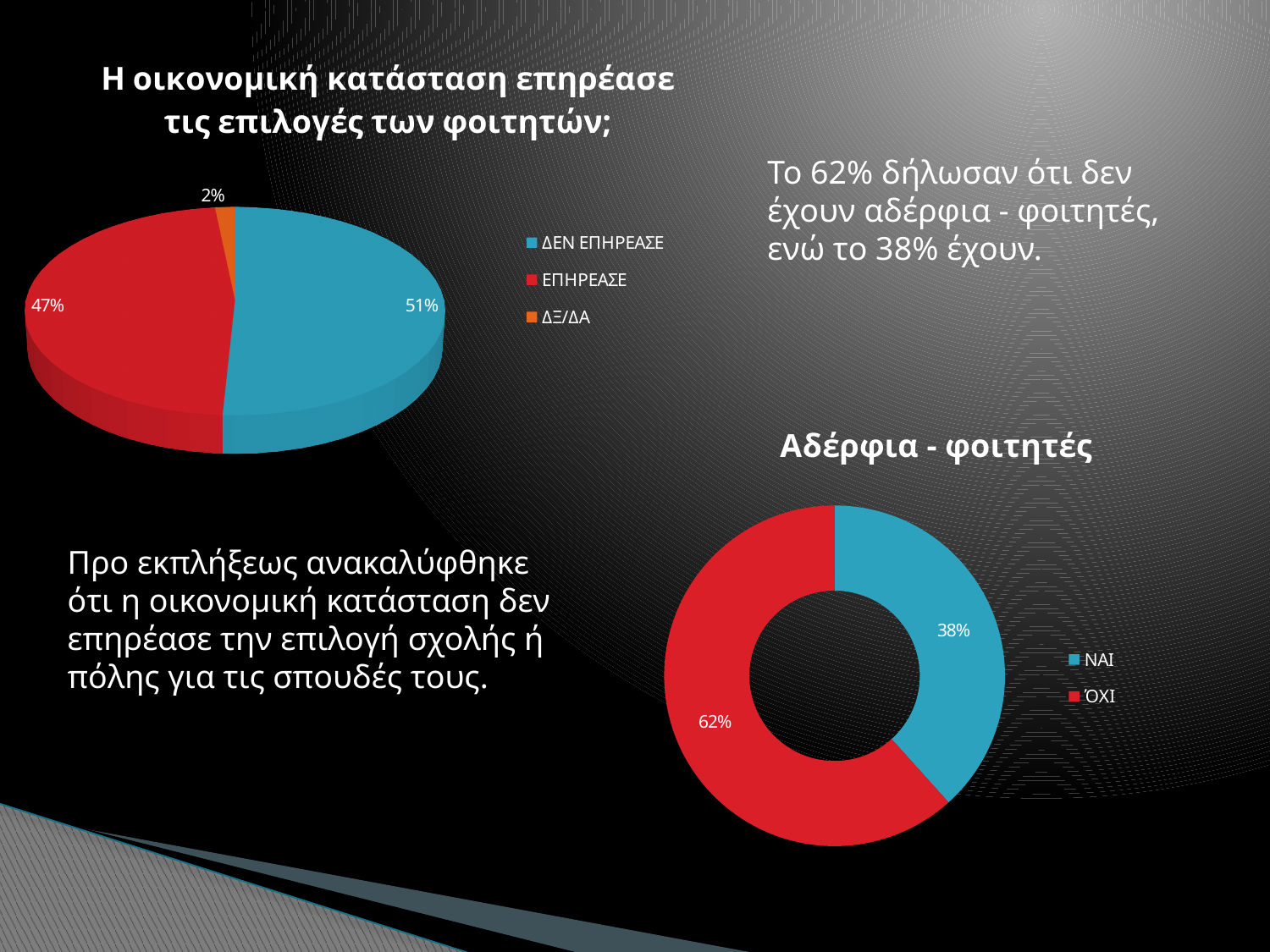
In the pie chart titled "Η οικονομική κατάσταση επηρέασε τις επιλογές των φοιτητών;", how many categories does the legend list? 3 In the pie chart titled "Η οικονομική κατάσταση επηρέασε τις επιλογές των φοιτητών;", what share is labelled for ΔΞ/ΔΑ? 2% In the chart titled "Αδέρφια - φοιτητές", what colour is the ΝΑΙ segment? Blue What kind of chart is the chart titled "Η οικονομική κατάσταση επηρέασε τις επιλογές των φοιτητών;"? Pie chart In the pie chart titled "Η οικονομική κατάσταση επηρέασε τις επιλογές των φοιτητών;", what is the difference in percentage points between ΔΕΝ ΕΠΗΡΕΑΣΕ and ΕΠΗΡΕΑΣΕ? 4 percentage points In the chart titled "Αδέρφια - φοιτητές", what share is labelled for ΝΑΙ? 38% In the pie chart titled "Η οικονομική κατάσταση επηρέασε τις επιλογές των φοιτητών;", what share is labelled for ΕΠΗΡΕΑΣΕ? 47% In the chart titled "Αδέρφια - φοιτητές", what is the difference in percentage points between ΌΧΙ and ΝΑΙ? 24 percentage points In the chart titled "Αδέρφια - φοιτητές", which category has the larger share? ΌΧΙ In the pie chart titled "Η οικονομική κατάσταση επηρέασε τις επιλογές των φοιτητών;", which category has the smallest slice? ΔΞ/ΔΑ In the pie chart titled "Η οικονομική κατάσταση επηρέασε τις επιλογές των φοιτητών;", what share is labelled for ΔΕΝ ΕΠΗΡΕΑΣΕ? 51% In the chart titled "Αδέρφια - φοιτητές", what share is labelled for ΌΧΙ? 62%